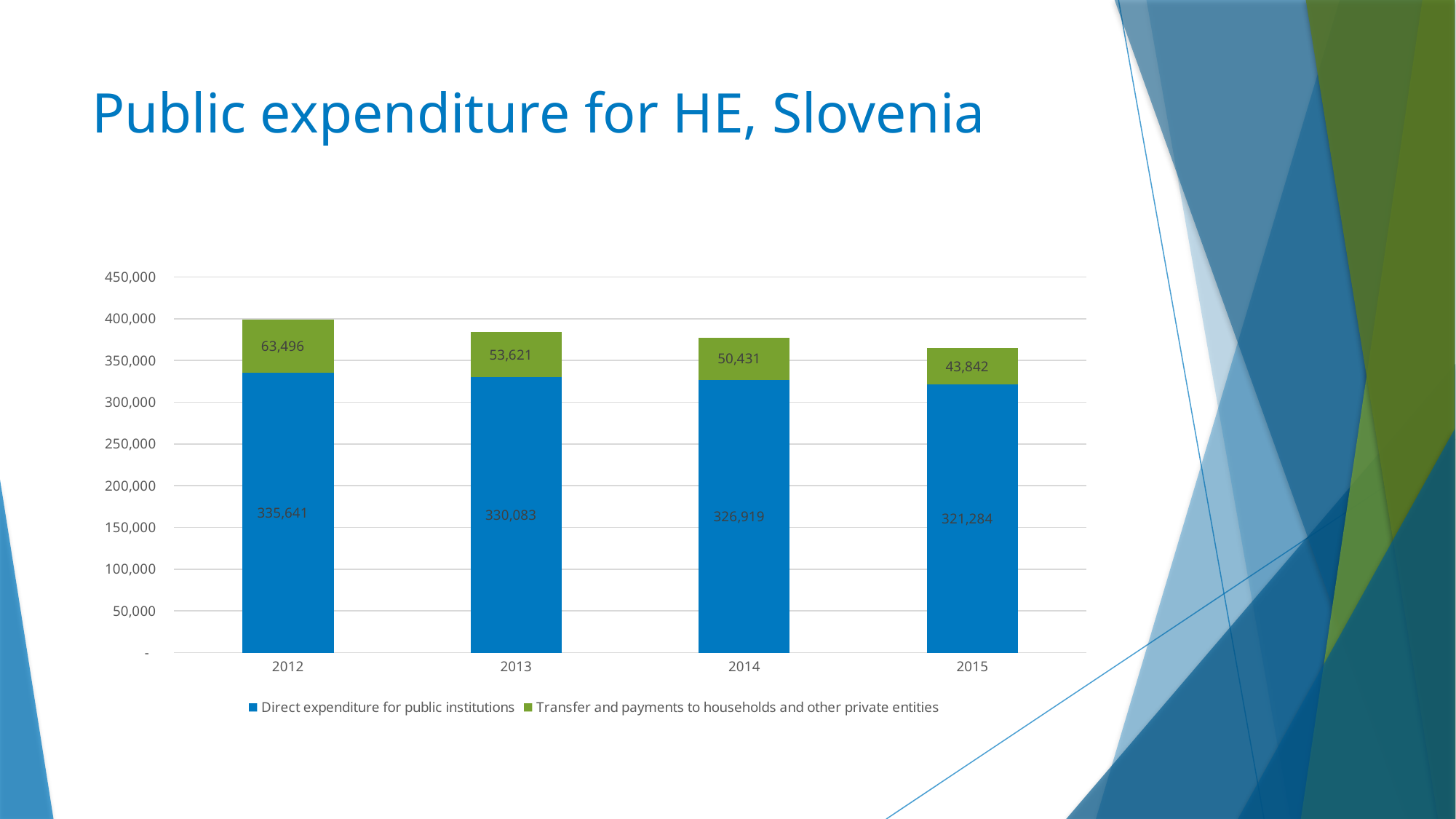
Which year has the highest value for Direct expenditure for public institutions? 2012 What is the value of Transfer and payments to households and other private entities in 2013? 53,621 Which year has the lowest value for Transfer and payments to households and other private entities? 2015 What is the difference between Transfer and payments to households and other private entities in 2012 and in 2015? 19,654 What is the total of the stacked bar for 2015? 365,126 What is the value of Direct expenditure for public institutions in 2012? 335,641 What is the total of the stacked bar for 2012? 399,137 How many years are shown on the x axis? 4 How many series does the legend list? 2 What is the value of Transfer and payments to households and other private entities in 2015? 43,842 Which is larger: Direct expenditure for public institutions in 2013 or in 2014? 2013 What is the difference between Direct expenditure for public institutions in 2012 and in 2015? 14,357